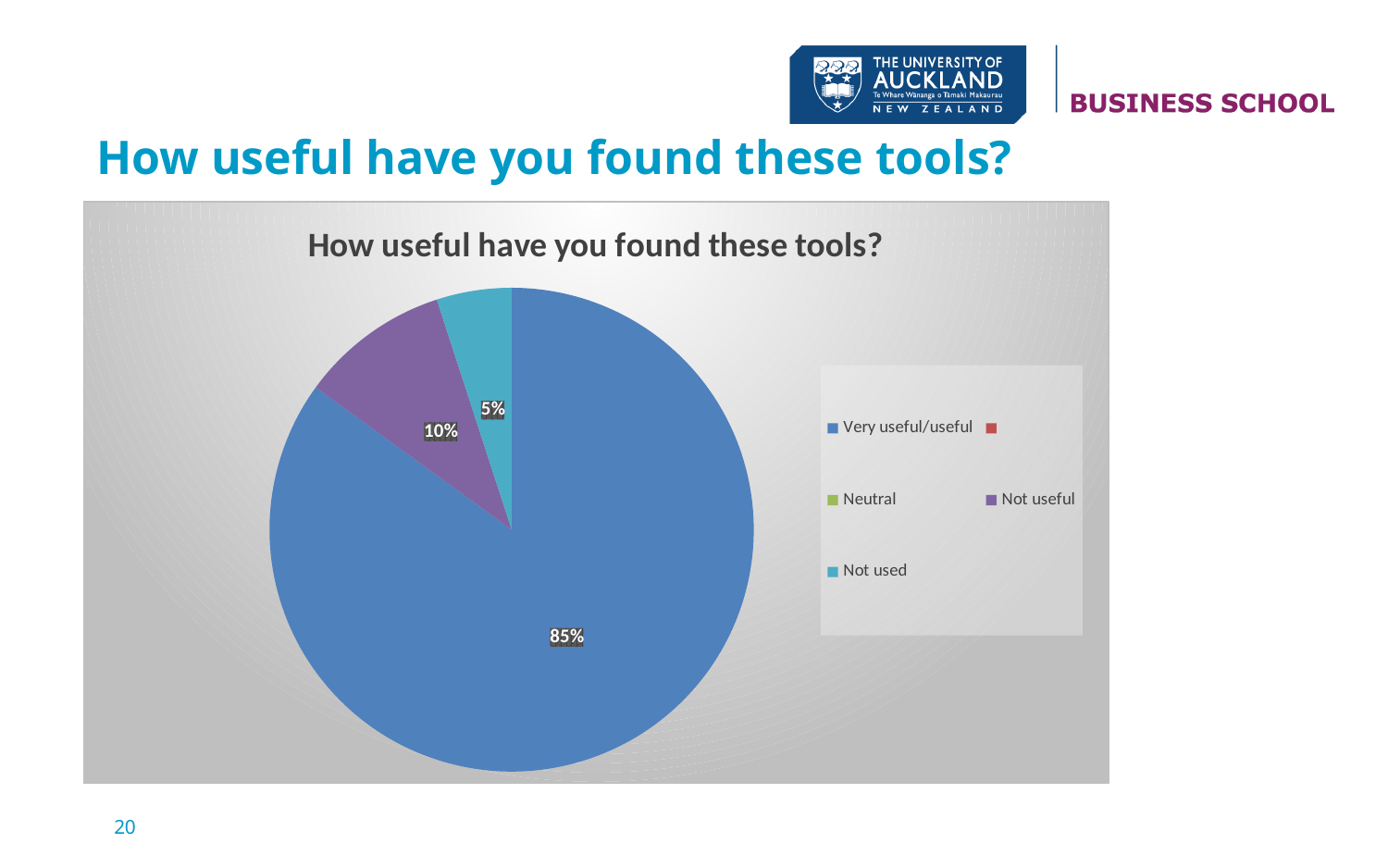
How many percentage points larger is the 'Not useful' share than the 'Not used' share? 5 percentage points What percentage of respondents said the tools were not useful? 10% What is the title of the chart? How useful have you found these tools? Which response category has the largest share of the pie? Very useful/useful Which is larger: the share for 'Not useful' or the share for 'Not used'? Not useful Which response category has the smallest share of the pie? Not used What percentage of respondents had not used the tools? 5% What percentage of respondents found the tools very useful/useful? 85% How many slices with data labels does the pie chart show? 3 What type of chart is shown on the slide? Pie chart How many percentage points larger is the 'Very useful/useful' share than the 'Not useful' share? 75 percentage points What colour is the slice representing 'Very useful/useful'? Blue